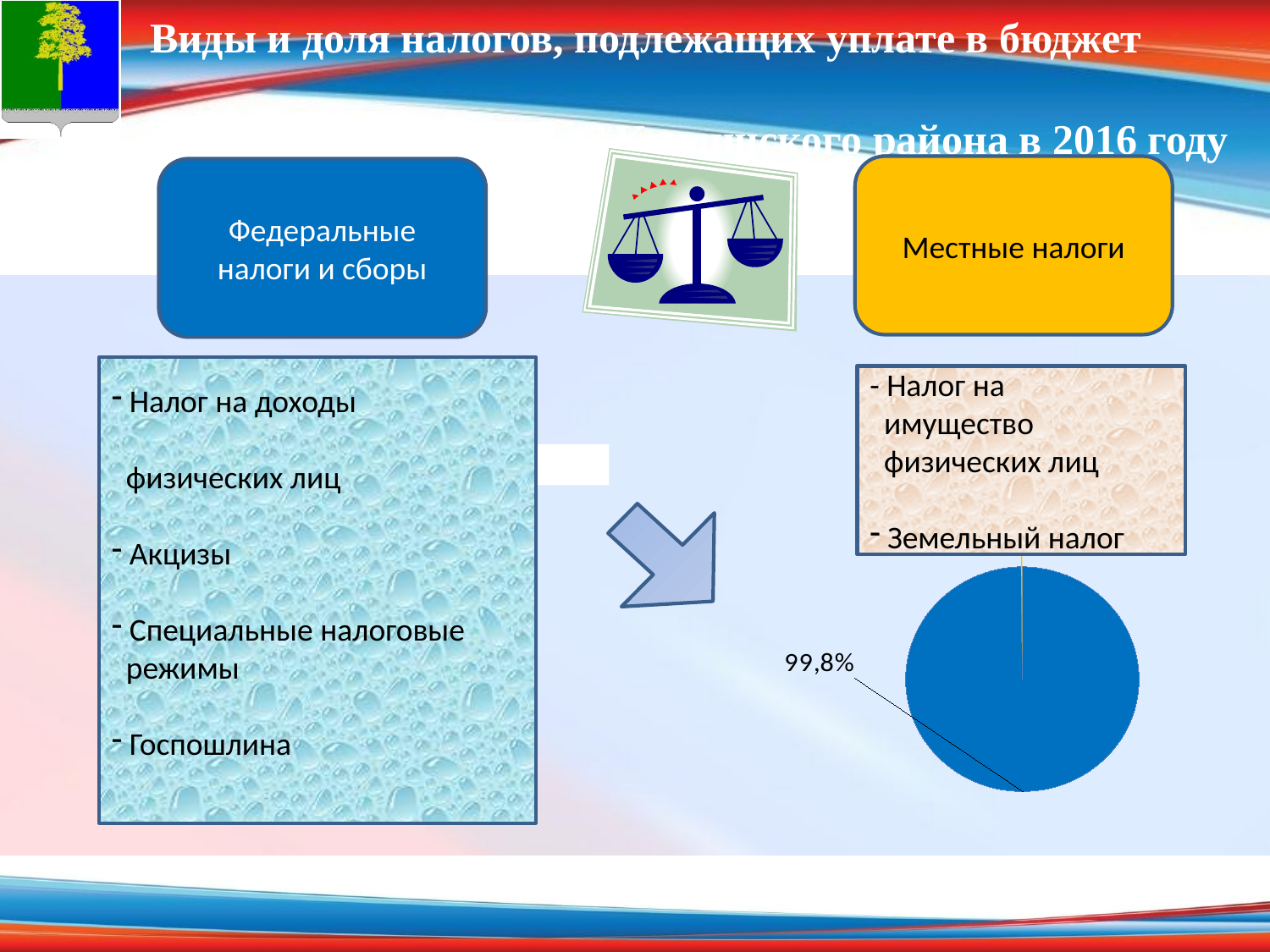
Does the pie chart have a legend? No Is the labelled slice of the pie chart greater or less than 90%? greater What percentage is printed as the data label on the pie chart? 99,8% What colour is the large slice of the pie chart? blue What share of the pie does the large blue slice represent, according to its label? 99,8% What kind of chart is shown at the bottom right of the slide? pie chart